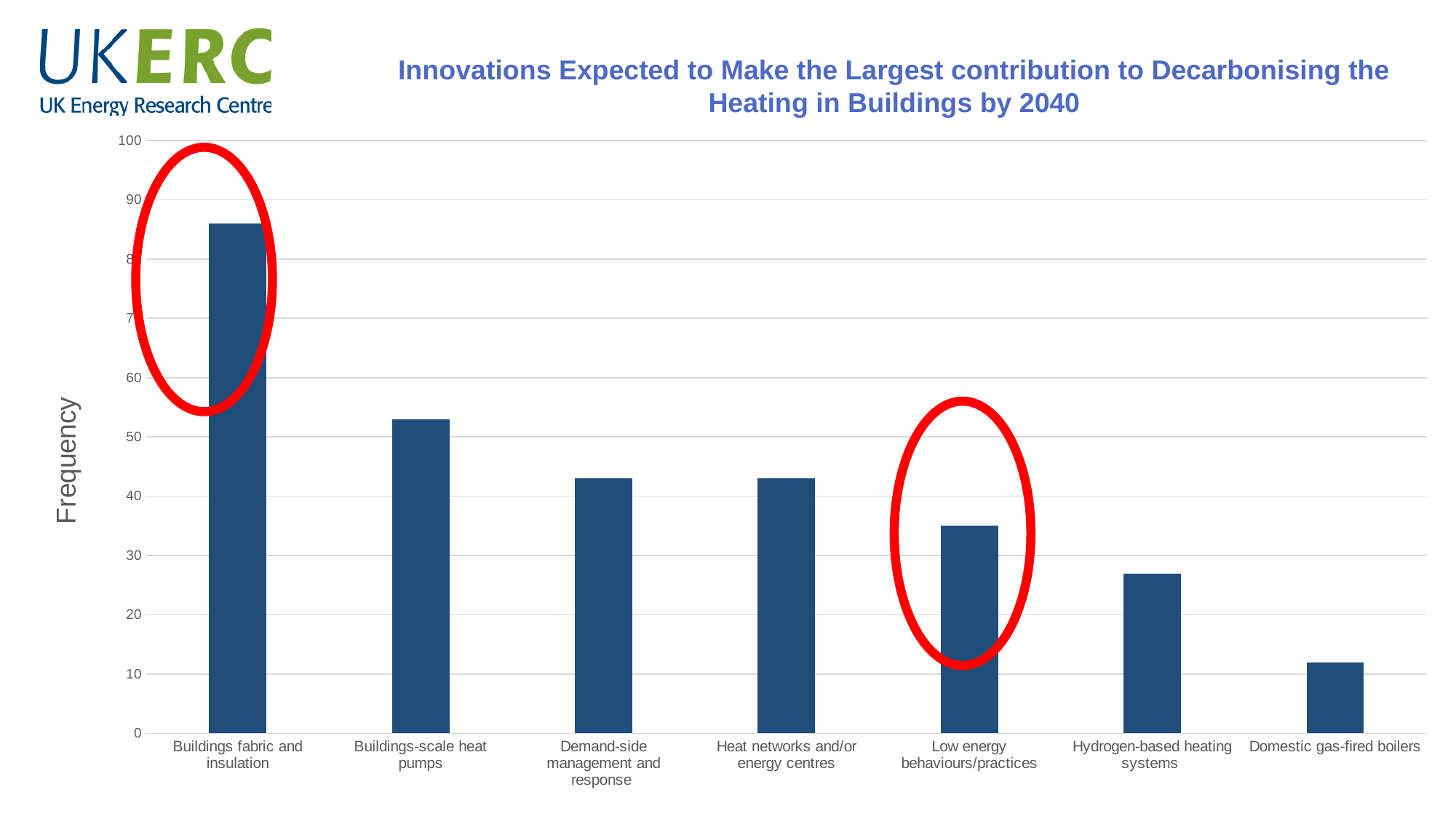
How many categories are plotted on the chart? 7 Which category has the highest frequency? Buildings fabric and insulation Do the frequencies generally rise or fall moving from left to right across the categories? fall Is the frequency for Hydrogen-based heating systems greater or less than 30? less Is the frequency for Buildings-scale heat pumps greater or less than 50? greater What kind of chart is shown on the slide? bar chart Which has a higher frequency, Buildings-scale heat pumps or Hydrogen-based heating systems? Buildings-scale heat pumps Is the frequency for Buildings fabric and insulation greater or less than 80? greater What is the label on the vertical axis of the chart? Frequency Which category has the lowest frequency? Domestic gas-fired boilers